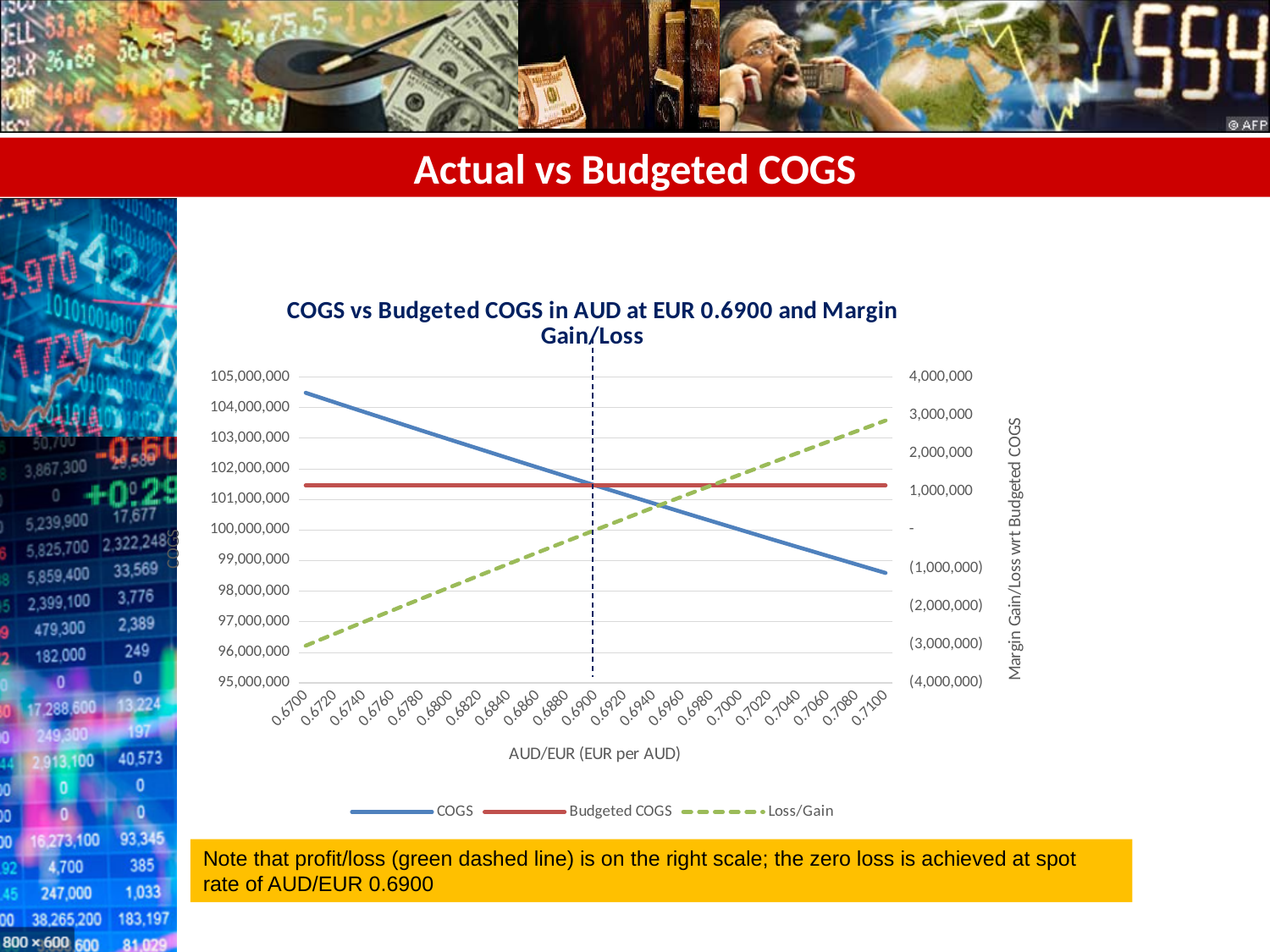
Does the Loss/Gain line rise or fall as the AUD/EUR rate increases along the x axis? rise Is the Loss/Gain value at AUD/EUR 0.7100 greater or less than 2,000,000 on the right-hand scale? greater How many series does the chart legend list? 3 Does the COGS line rise or fall as the AUD/EUR rate increases from 0.6700 to 0.7100? fall Is the COGS value at AUD/EUR 0.7100 greater or less than 99,000,000? less At which AUD/EUR rate does the Loss/Gain line reach zero, as marked by the vertical dashed line? 0.6900 Is the COGS value at AUD/EUR 0.6700 greater or less than 104,000,000? greater What kind of chart is shown on the slide? line chart How many AUD/EUR rate points are labelled along the x axis? 21 What is the title of the chart's x axis? AUD/EUR (EUR per AUD) At AUD/EUR 0.6700, which is larger: COGS or Budgeted COGS? COGS What are the three series named in the chart legend? COGS, Budgeted COGS, Loss/Gain